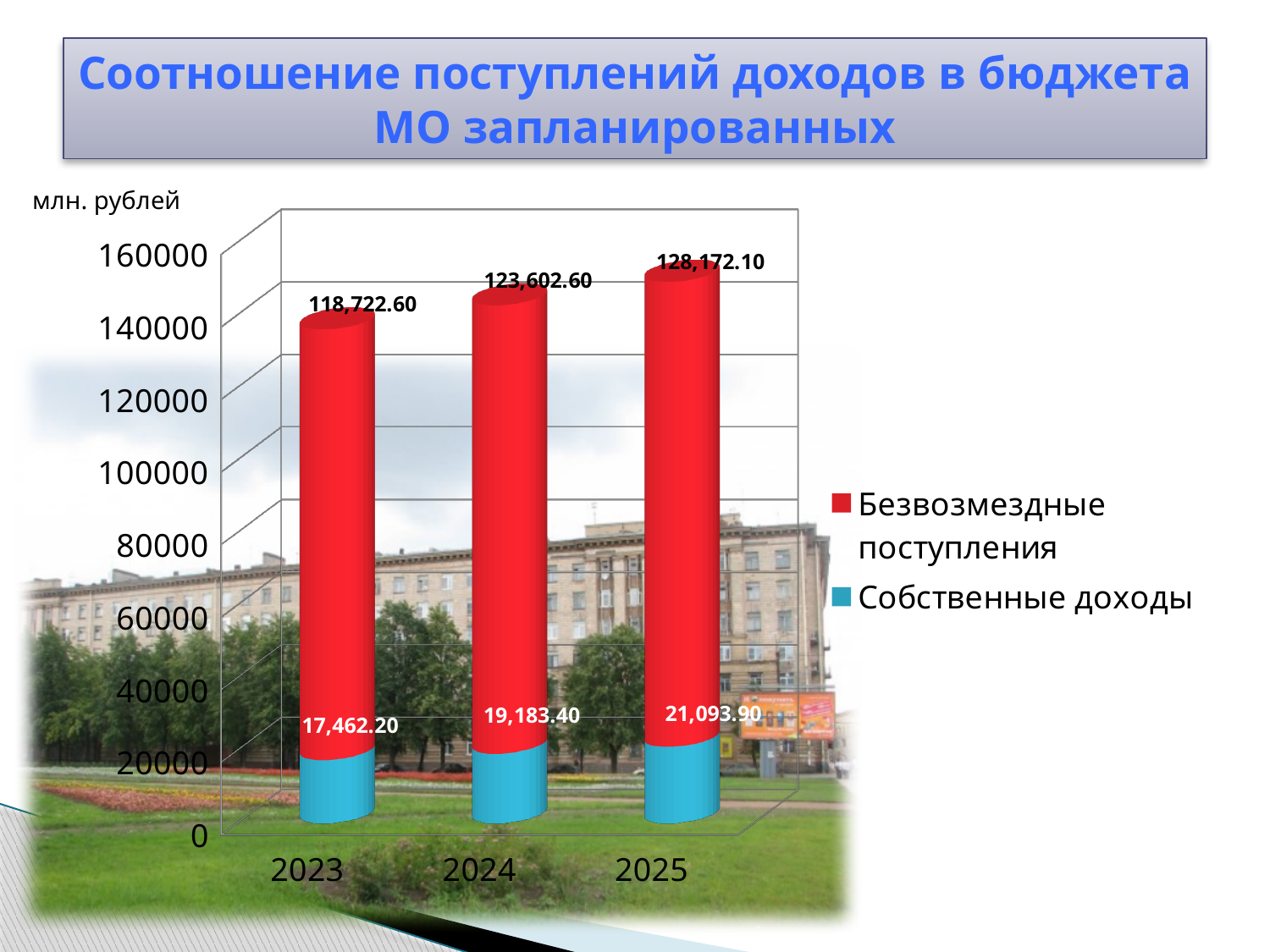
Which year has the lowest value for Собственные доходы? 2023 How many years are shown on the x axis? 3 How many series does the legend list? 2 What kind of chart is shown on the slide? Stacked bar chart What is the difference between the Безвозмездные поступления values for 2025 and 2023? 9,449.50 What is the value of Собственные доходы for 2024? 19,183.40 What is the value of Собственные доходы for 2025? 21,093.90 Which year has the highest value for Безвозмездные поступления? 2025 What is the value of Безвозмездные поступления for 2023? 118,722.60 Which is larger: Собственные доходы in 2024 or in 2025? 2025 What is the total of the stacked bar for 2024? 142,786.00 Do the Безвозмездные поступления values rise or fall from 2023 to 2025? Rise